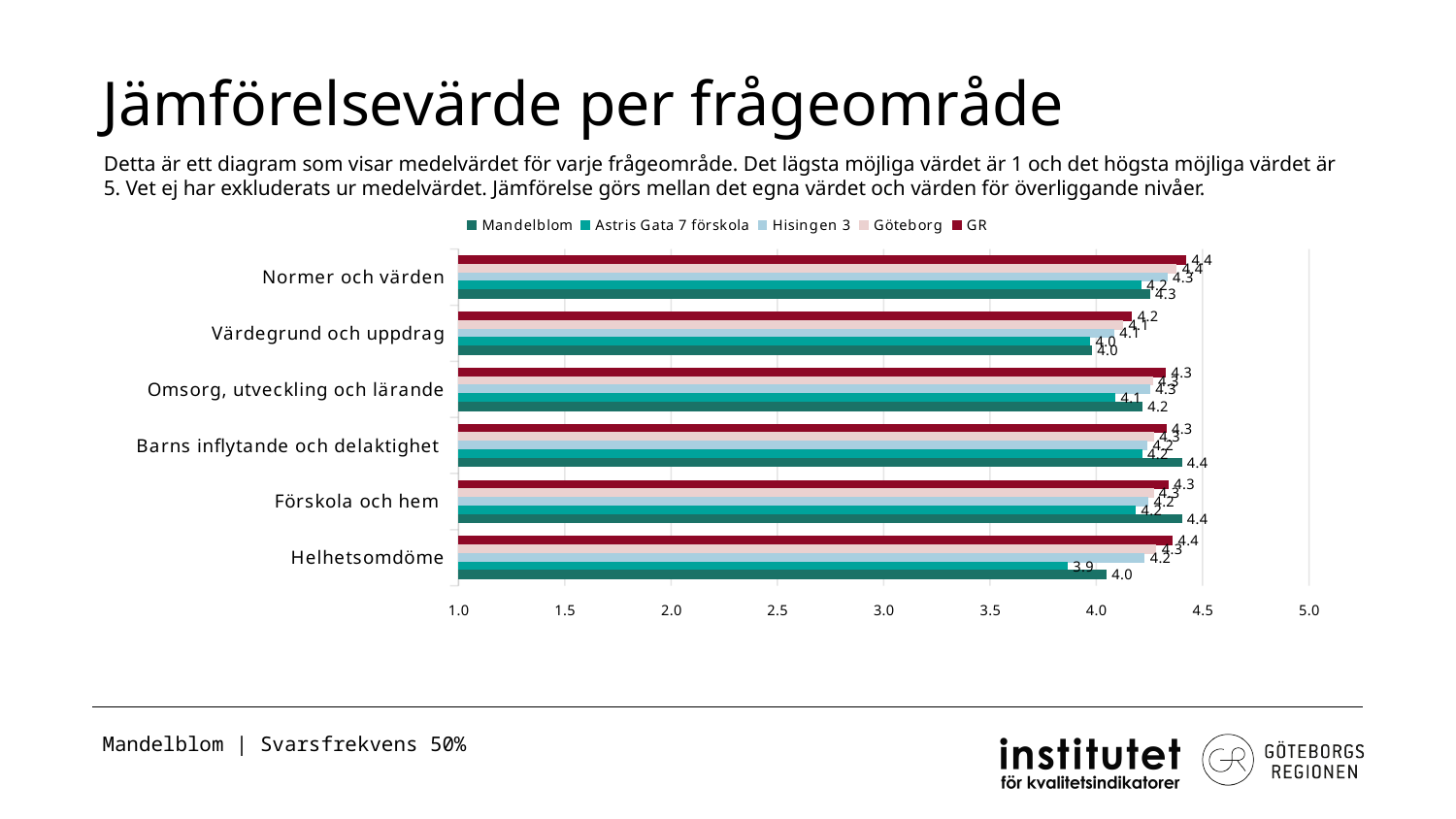
What is the value for Mandelblom in the category Värdegrund och uppdrag? 4.0 What is the difference between the Mandelblom value and the Astris Gata 7 förskola value for Helhetsomdöme? 0.1 How many series does the legend list? 5 Is the value for Astris Gata 7 förskola in Helhetsomdöme greater or less than 4.0? less What is the value for Mandelblom in the category Barns inflytande och delaktighet? 4.4 What kind of chart is shown on the slide? Bar chart What is the value for Mandelblom in the category Helhetsomdöme? 4.0 In which category does Astris Gata 7 förskola have its lowest value? Helhetsomdöme For Barns inflytande och delaktighet, which is larger: the Mandelblom value or the GR value? Mandelblom What is the value for Astris Gata 7 förskola in the category Helhetsomdöme? 3.9 How many question areas (categories) are shown on the y axis? 6 What is the value for Mandelblom in the category Omsorg, utveckling och lärande? 4.2